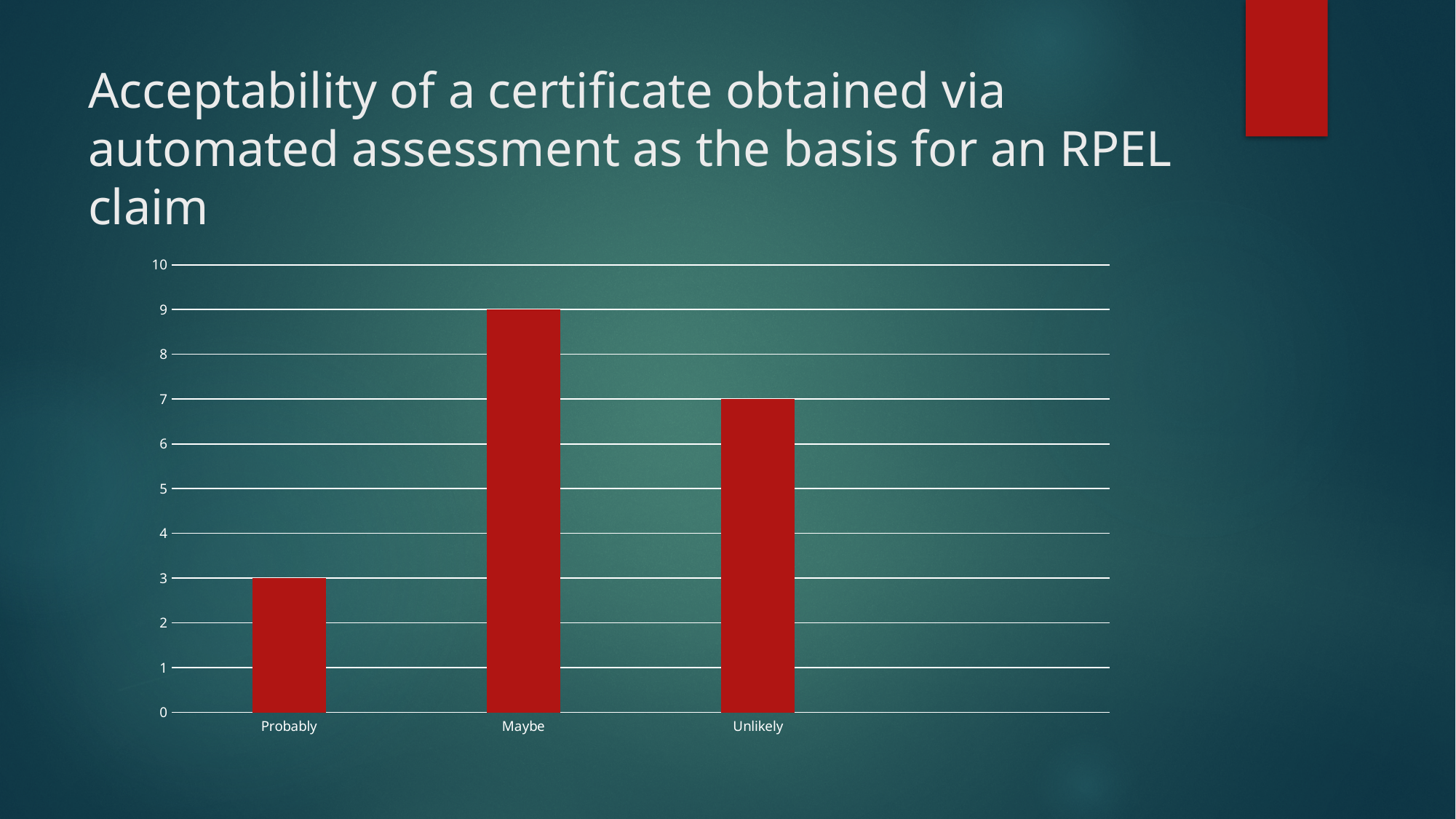
What is the difference between the values for Unlikely and Probably? 4 Which category has the lowest value? Probably What is the value for Probably? 3 What kind of chart is shown on the slide? bar chart What is the value for Unlikely? 7 Which is larger, the value for Probably or the value for Unlikely? Unlikely How many categories are shown on the x axis? 3 What is the title of the slide? Acceptability of a certificate obtained via automated assessment as the basis for an RPEL claim What is the value for Maybe? 9 Is the value for Maybe greater or less than 8? greater What is the difference between the values for Maybe and Unlikely? 2 Which category has the highest value? Maybe